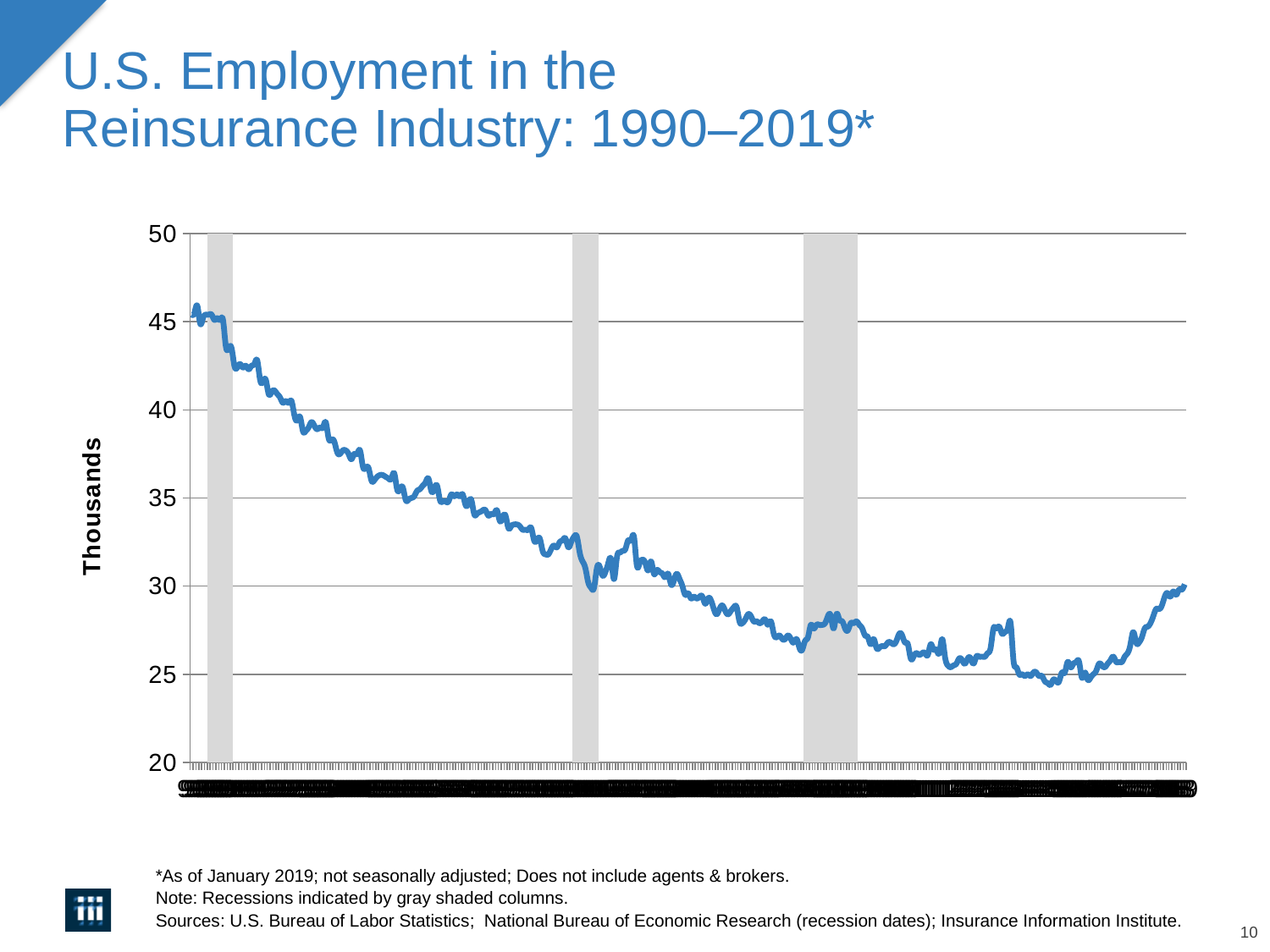
Is the value at the start of the series larger or smaller than the value at the end of the series? larger Is the highest point of the line greater or less than 50? less Is the lowest point of the line greater or less than 30? less How many data series (lines) are plotted on the chart? 1 Is the employment value at the end of the series (2019) greater or less than 25? greater Overall, does reinsurance industry employment rise or fall from 1990 to 2019 along the x axis? fall How many gray shaded recession columns appear on the chart? 3 What kind of chart is shown on the slide? line chart What is the title of the vertical axis? Thousands